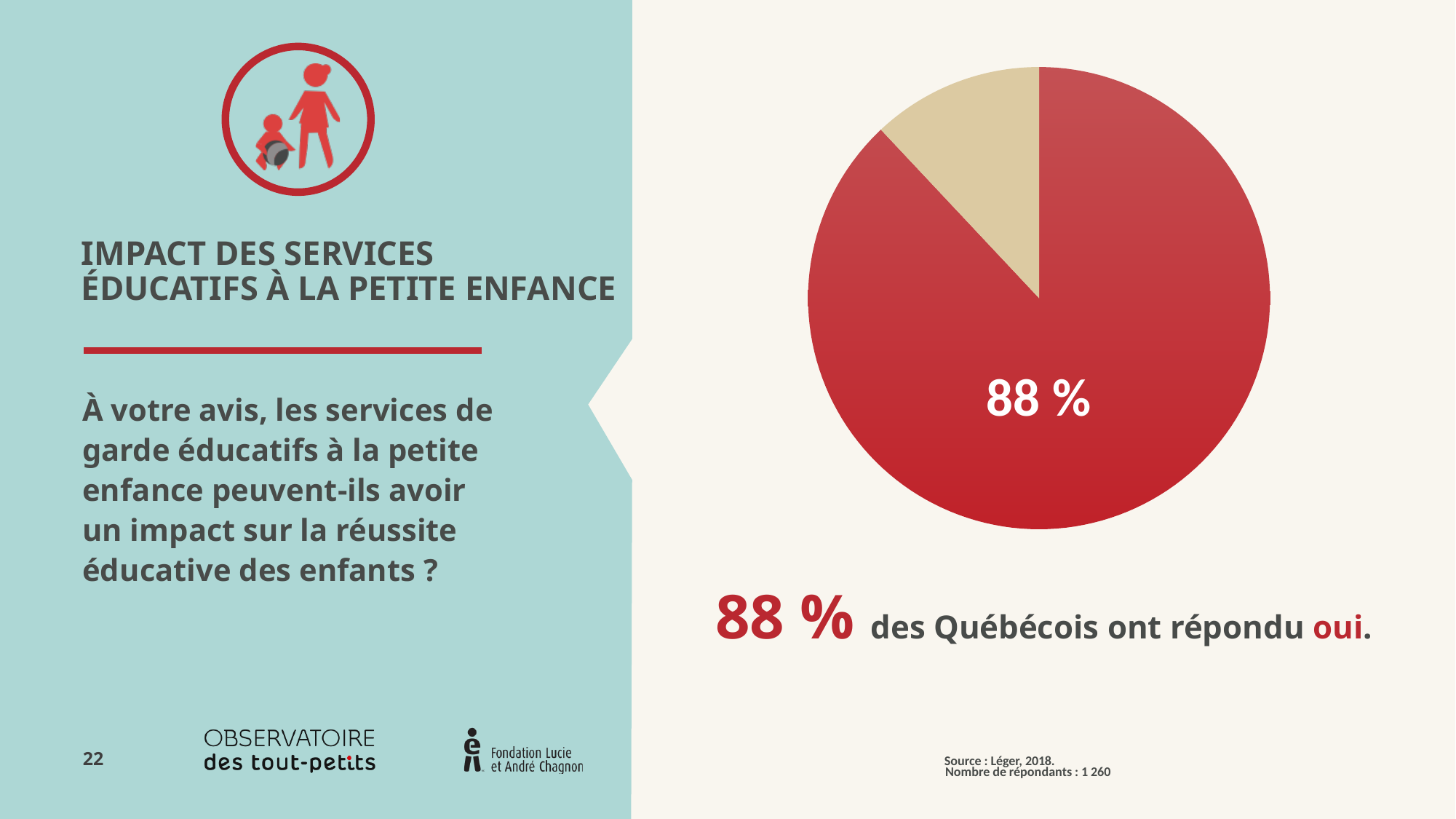
What colour is the largest slice of the pie chart? red What kind of chart is shown on the slide? pie chart Which slice of the pie chart is the smallest? the beige slice How many slices does the pie chart have? 2 What share of the pie does the red slice represent? 88 % How many respondents does the source note below the chart give? 1 260 Which slice of the pie chart is larger, the red one or the beige one? the red one What percentage is printed on the large red slice of the pie chart? 88 % According to the slide, what percentage of Québécois answered 'oui'? 88 %